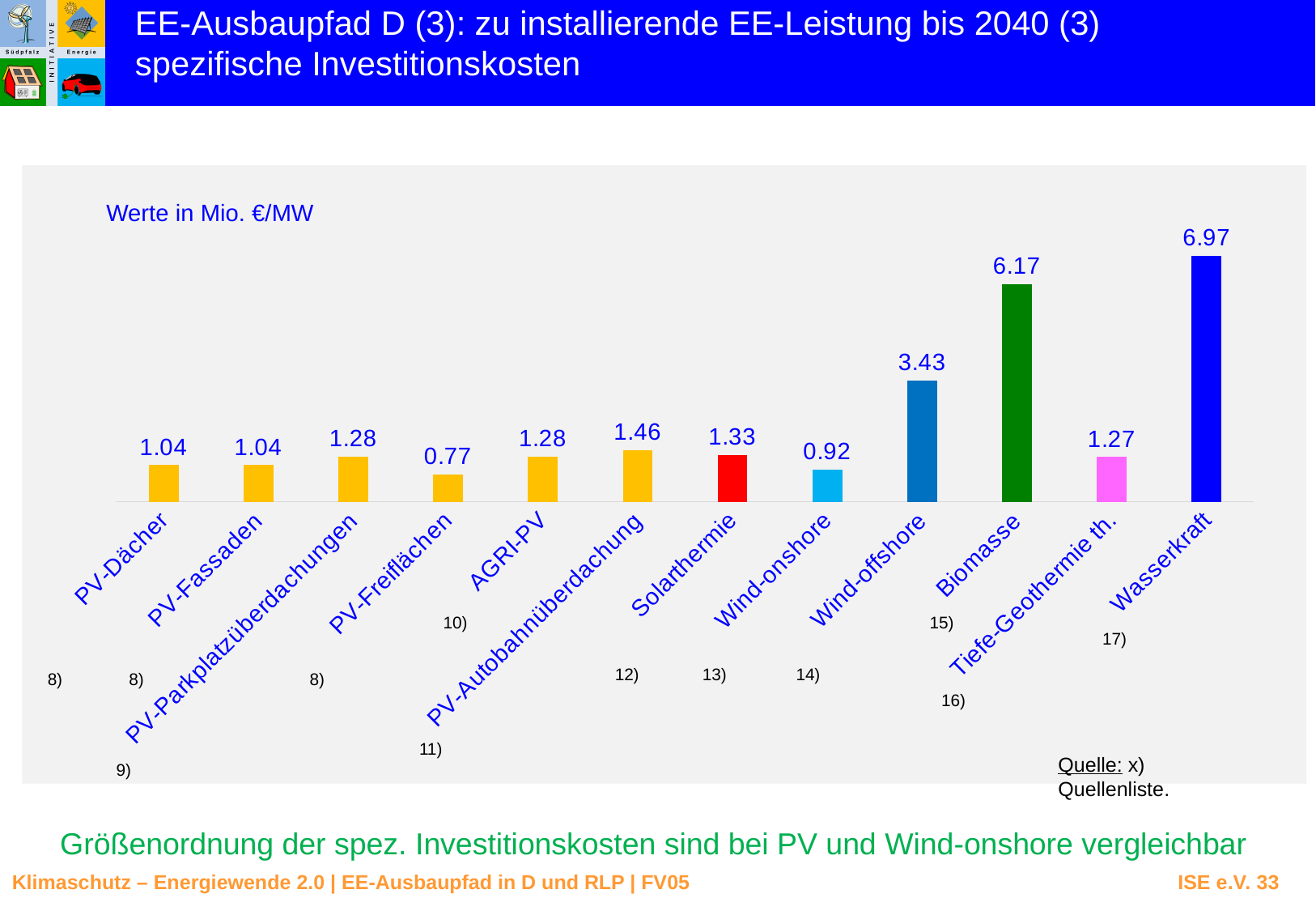
What unit are the values in the chart given in? Mio. €/MW What is the value for PV-Freiflächen? 0.77 What is the value for Tiefe-Geothermie th.? 1.27 What kind of chart is shown on the slide? Bar chart Which category has the lowest value? PV-Freiflächen Which is larger, the value for Solarthermie or the value for PV-Autobahnüberdachung? PV-Autobahnüberdachung What is the value for Wasserkraft? 6.97 What is the value for Wind-offshore? 3.43 How many categories are shown in the chart? 12 Which category has the highest value? Wasserkraft What is the difference between the values for Wind-offshore and Wind-onshore? 2.51 What is the difference between the values for Wasserkraft and Biomasse? 0.80